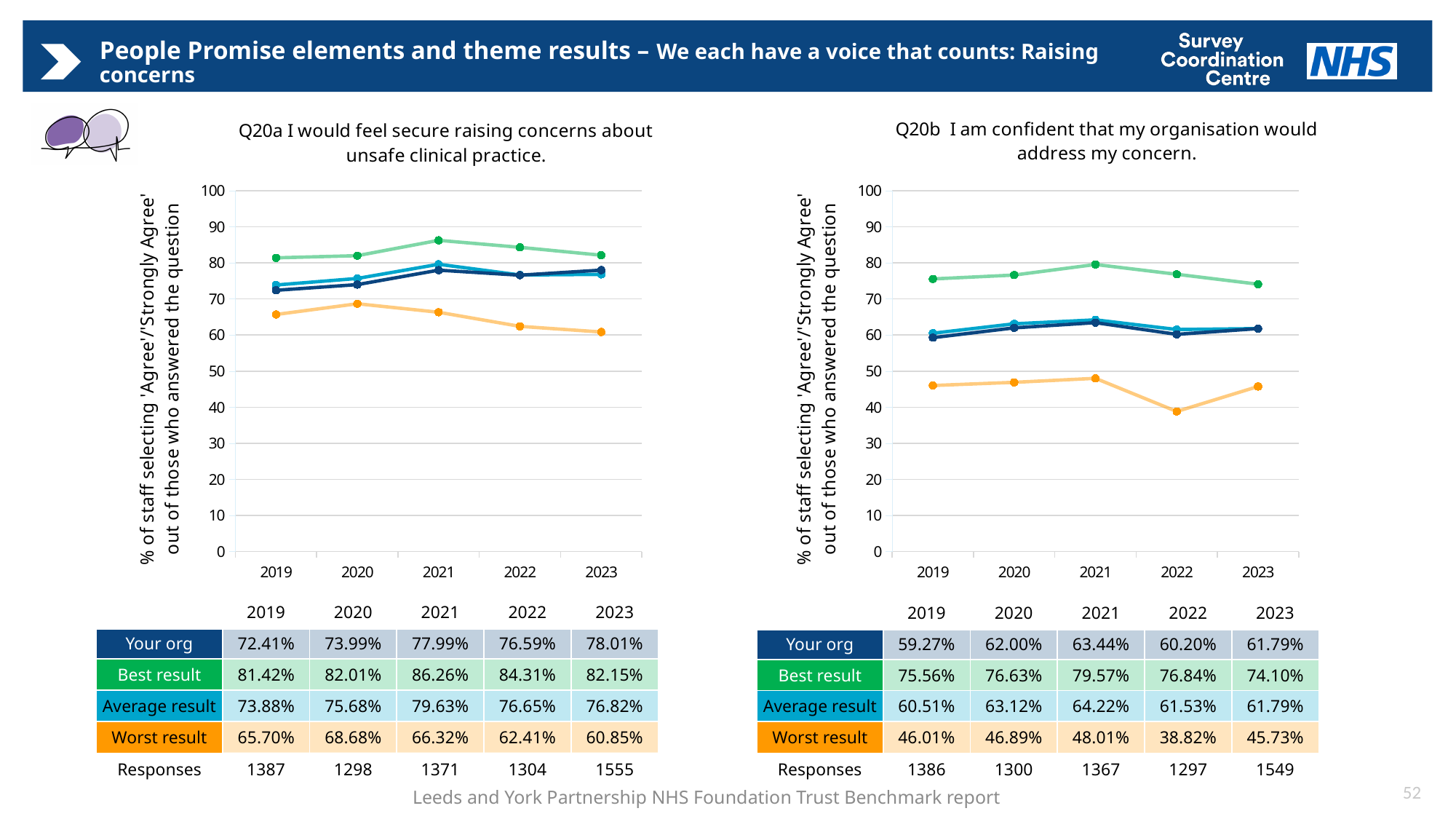
In the Q20a chart, in which year is the Best result highest? 2021 In the Q20b chart, what is the Best result value for 2019? 75.56% In the Q20b chart, in which year is the Worst result lowest? 2022 In the Q20a chart, which is larger in 2020: Your org or the Average result? Average result In the Q20a chart, what is the difference between the Best result and Your org in 2023? 4.14 percentage points What kind of chart is used for Q20b? Line chart In the Q20a chart, does the Worst result rise or fall from 2020 to 2023? Fall How many years are shown on the x axis of the Q20b chart? 5 In the Q20a chart, is the Worst result value for 2023 greater or less than 70? less In the Q20b chart, what is the Worst result value for 2022? 38.82% How many lines are plotted in the Q20a chart? 4 In the Q20a chart, what is the Your org value for 2021? 77.99%